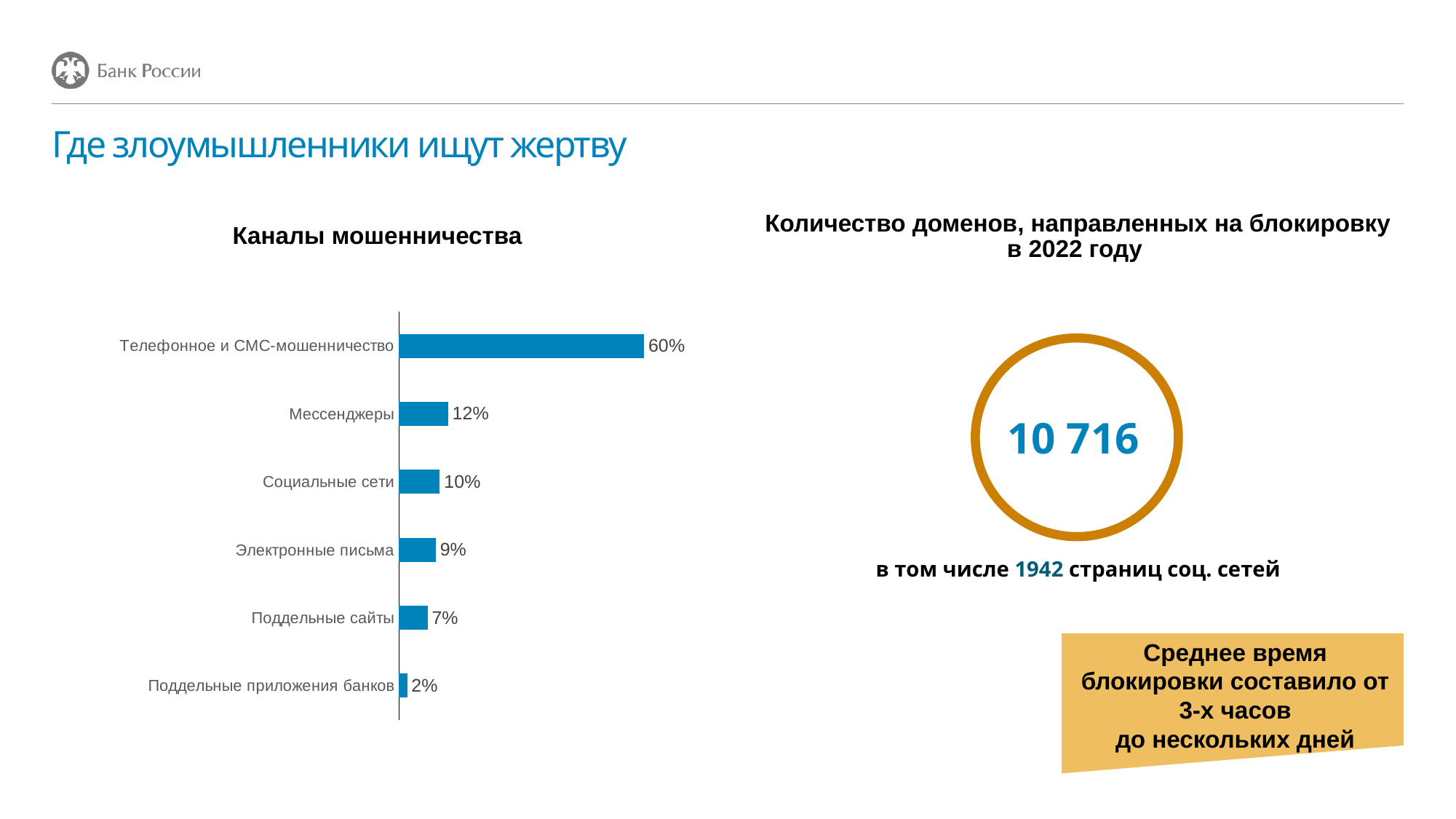
What kind of chart is Каналы мошенничества? Bar chart Which is larger in the Каналы мошенничества chart: Социальные сети or Поддельные сайты? Социальные сети Which category has the highest value in the Каналы мошенничества chart? Телефонное и СМС-мошенничество What is the value for Мессенджеры in the Каналы мошенничества chart? 12% What is the difference between the values for Электронные письма and Поддельные сайты in the Каналы мошенничества chart? 2% How many categories are shown in the Каналы мошенничества chart? 6 What is the value for Телефонное и СМС-мошенничество in the Каналы мошенничества chart? 60% What is the value for Поддельные приложения банков in the Каналы мошенничества chart? 2% Which category has the lowest value in the Каналы мошенничества chart? Поддельные приложения банков What is the value for Социальные сети in the Каналы мошенничества chart? 10% What is the difference between the values for Телефонное и СМС-мошенничество and Мессенджеры in the Каналы мошенничества chart? 48% What is the title of the chart on the left side of the slide? Каналы мошенничества